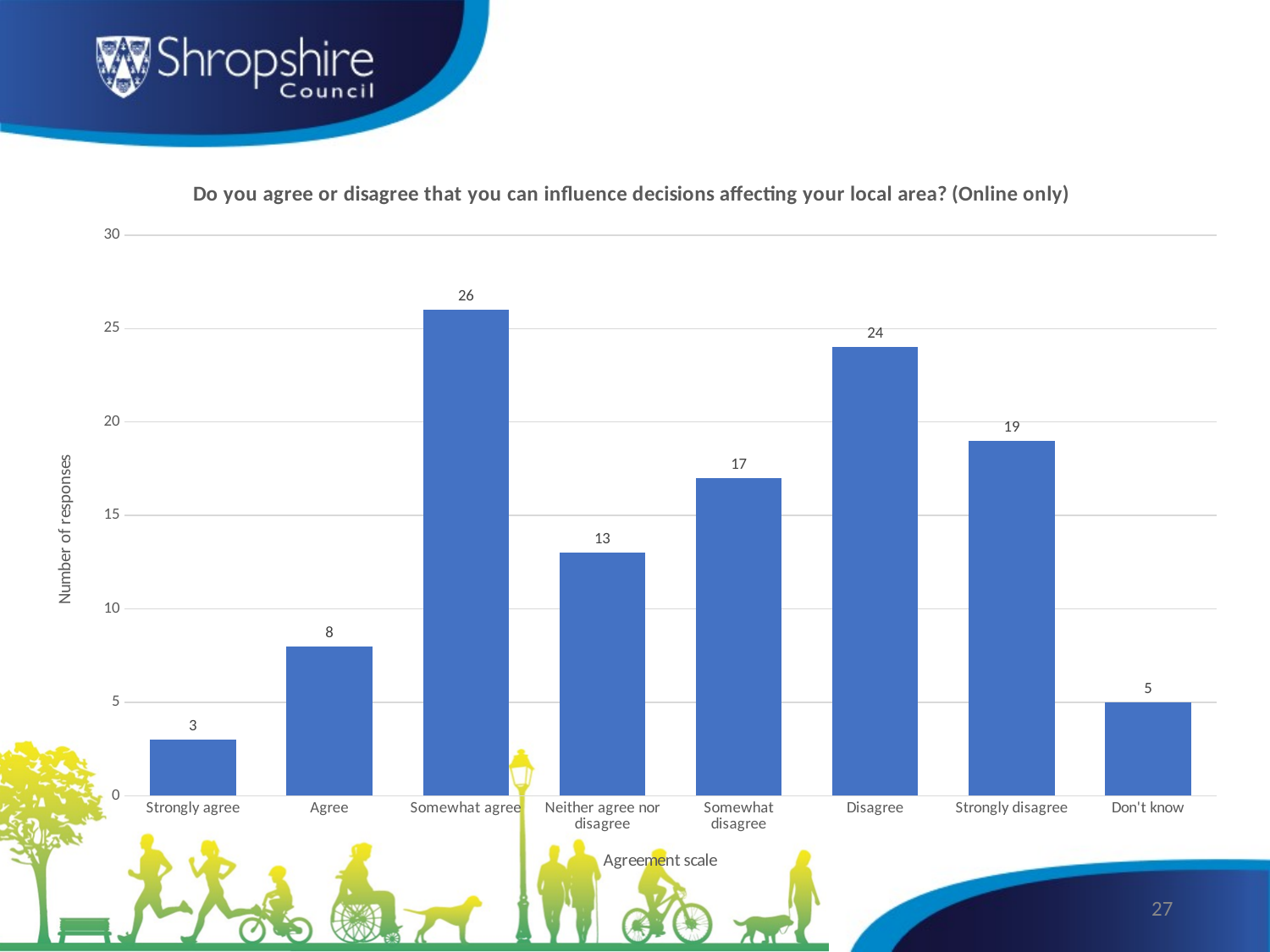
Which category has the lowest number of responses? Strongly agree Which category has the highest number of responses? Somewhat agree What is the label of the y axis? Number of responses Is the value for 'Neither agree nor disagree' greater or less than 15? less How many responses were recorded for 'Don't know'? 5 How many categories are shown on the x axis? 8 What is the difference in responses between 'Somewhat disagree' and 'Neither agree nor disagree'? 4 What is the difference in responses between 'Disagree' and 'Agree'? 16 Which has more responses, 'Disagree' or 'Strongly disagree'? Disagree How many responses were recorded for 'Somewhat agree'? 26 What is the number of responses for 'Strongly disagree'? 19 What type of chart is shown on the slide? Bar chart